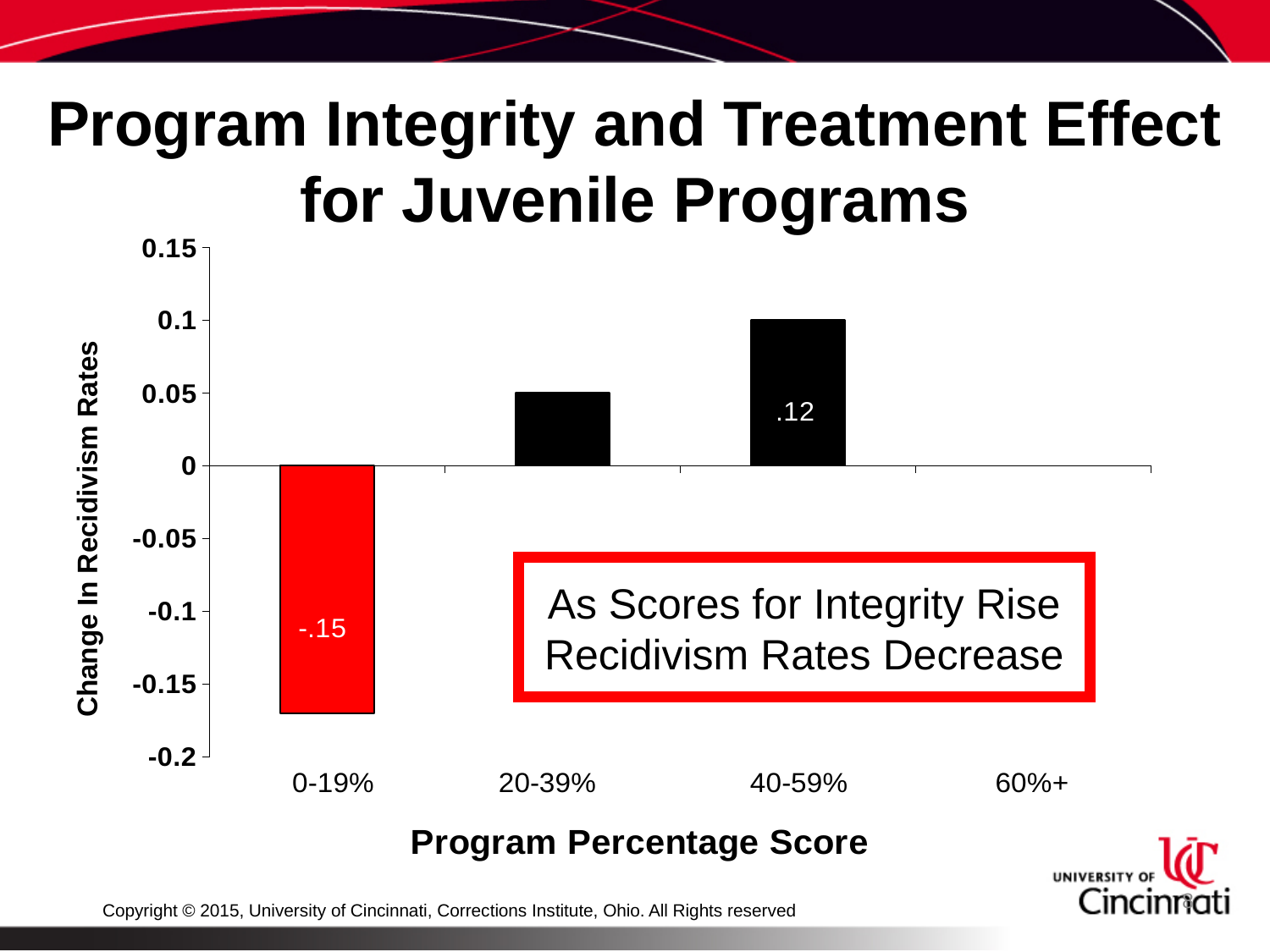
What colour is the bar for the 0-19% category? red Which has the larger change in recidivism rates, 20-39% or 40-59%? 40-59% What is the data label shown on the bar for the 40-59% program percentage score? .12 What is the data label shown on the bar for the 0-19% program percentage score? -.15 Which program percentage score category has the highest change in recidivism rates? 40-59% Do the bar values rise or fall from the 0-19% category to the 40-59% category? rise What is the title of the y axis? Change In Recidivism Rates What is the change in recidivism rates for the 20-39% program percentage score? 0.05 Which program percentage score category has the lowest change in recidivism rates? 0-19% How many program percentage score categories are labelled on the x axis? 4 What type of chart is shown on the slide? bar chart Is the value for the 0-19% category greater or less than -0.1? less